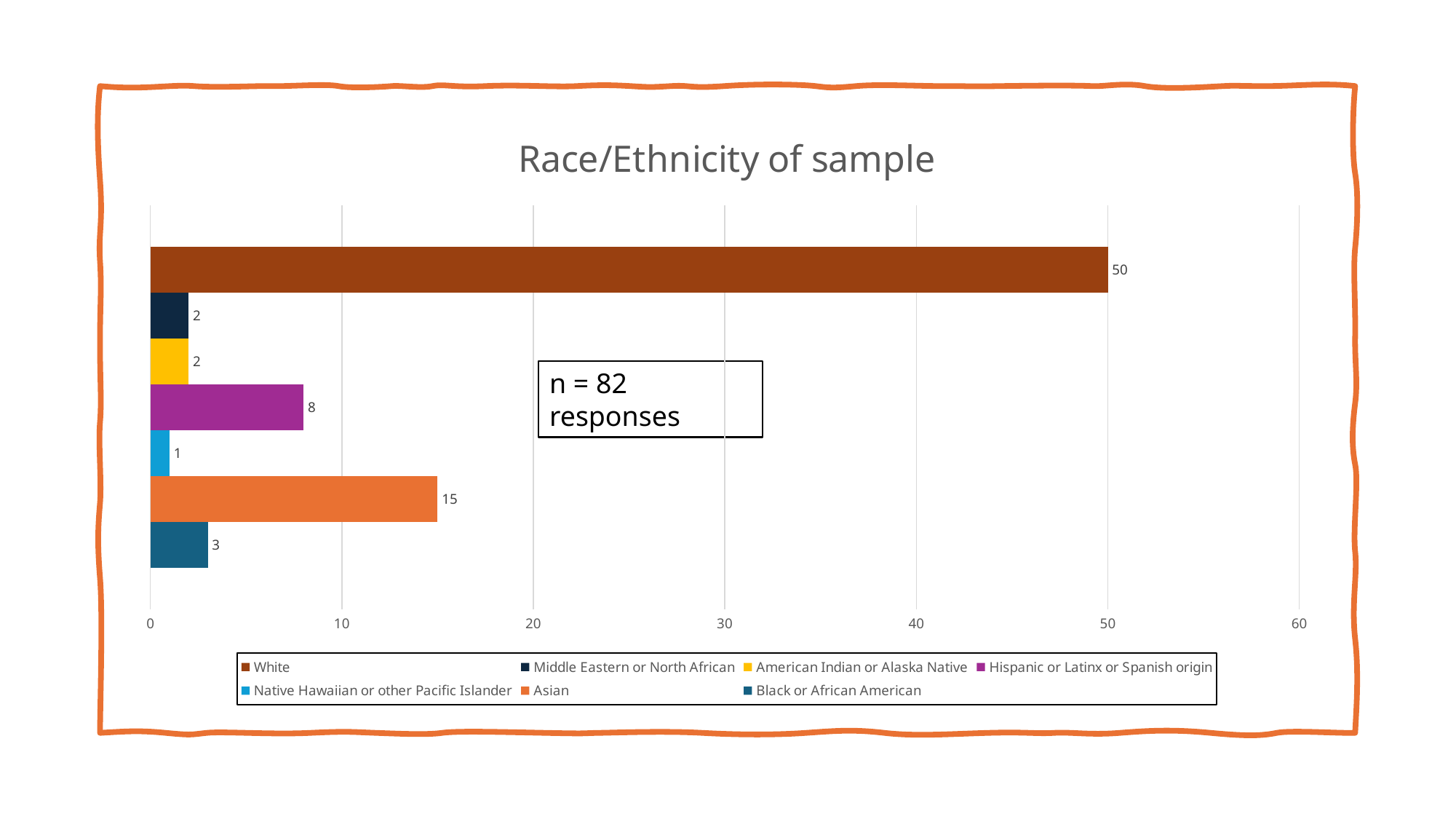
What is the value for Native Hawaiian or other Pacific Islander? 1 What is the value for White? 50 Which category has the lowest value? Native Hawaiian or other Pacific Islander What is the value for Black or African American? 3 Which category has the highest value? White What is the title of the chart? Race/Ethnicity of sample Which is larger, the value for Asian or the value for Hispanic or Latinx or Spanish origin? Asian How many series does the legend list? 7 What kind of chart is shown? Bar chart What is the value for Asian? 15 What is the value for Hispanic or Latinx or Spanish origin? 8 What is the difference between the values for White and Asian? 35